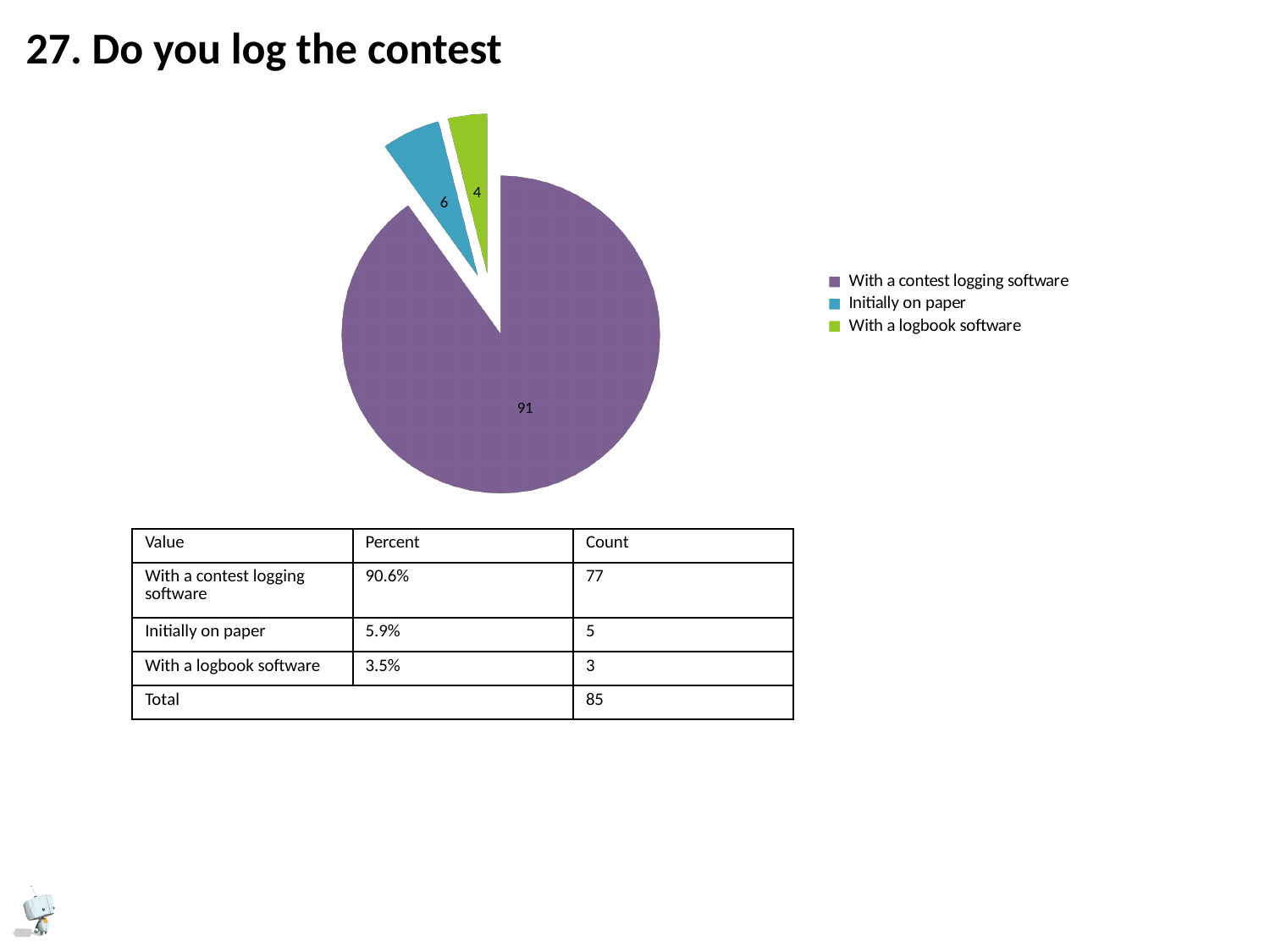
What type of chart is shown on the slide? pie chart What is the title of the slide containing the pie chart? 27. Do you log the contest Which category has the largest slice in the pie chart? With a contest logging software What is the difference between the data labels for 'With a contest logging software' and 'Initially on paper' in the pie chart? 85 What colour is the slice for 'With a contest logging software' in the pie chart? purple What is the data label on the pie slice for 'With a logbook software'? 4 What is the data label on the pie slice for 'With a contest logging software'? 91 Which slice is larger in the pie chart: 'Initially on paper' or 'With a logbook software'? Initially on paper What is the data label on the pie slice for 'Initially on paper'? 6 How many slices does the pie chart have? 3 How many entries does the legend of the pie chart list? 3 Which category has the smallest slice in the pie chart? With a logbook software